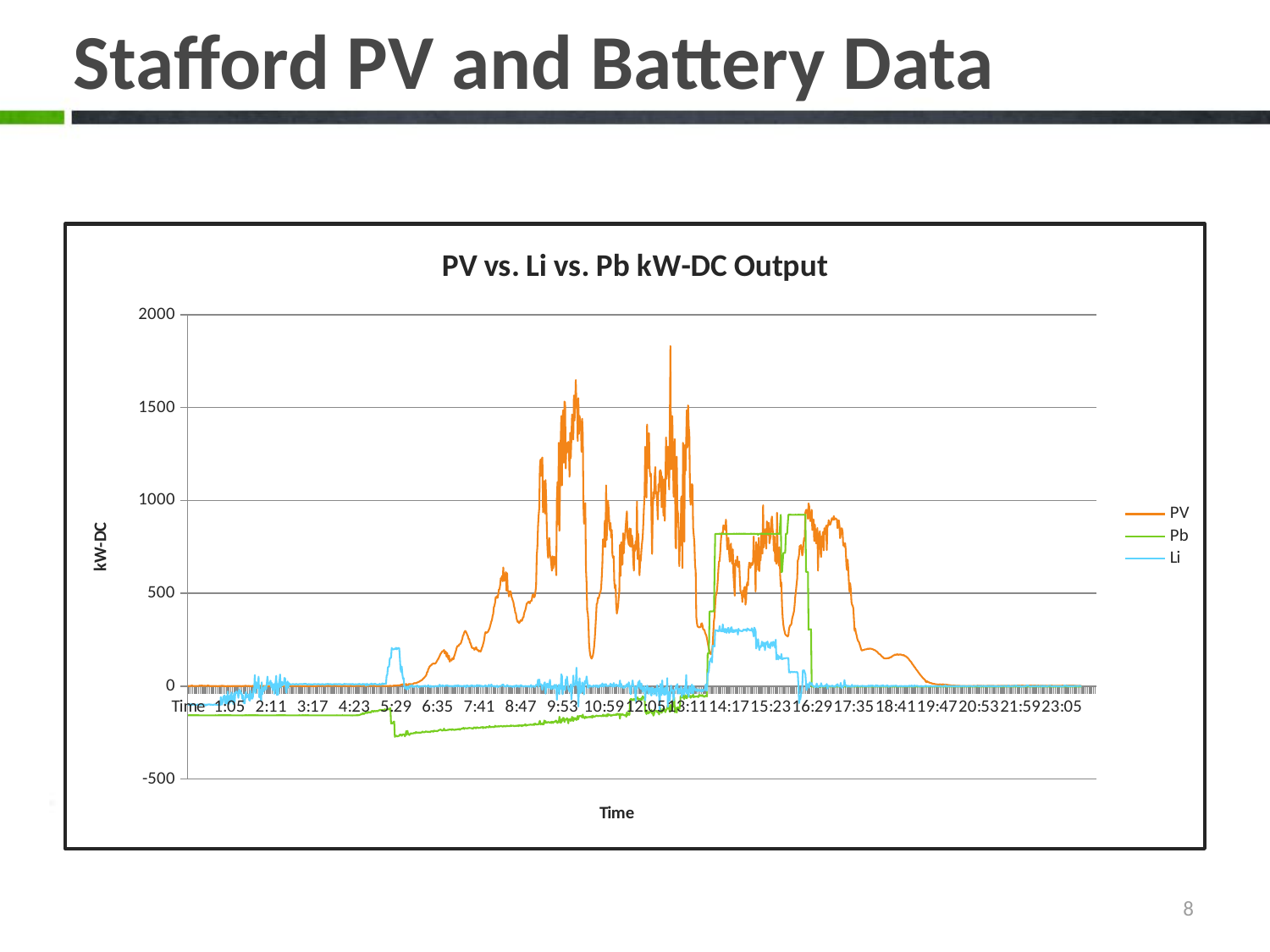
Between 6:35 and 9:53, does the PV series generally rise or fall? rise How many series does the legend list? 3 Around 14:17, which series has the higher value, Pb or Li? Pb Is the maximum value reached by the Li series greater or less than 500? less Is the lowest value of the Pb series greater or less than 0? less What is the title of the chart? PV vs. Li vs. Pb kW-DC Output Which series reaches the highest value on the chart? PV What is the label on the vertical axis of the chart? kW-DC Is the value of the PV series at 18:41 greater or less than 500? less What kind of chart is shown on the slide? Line chart